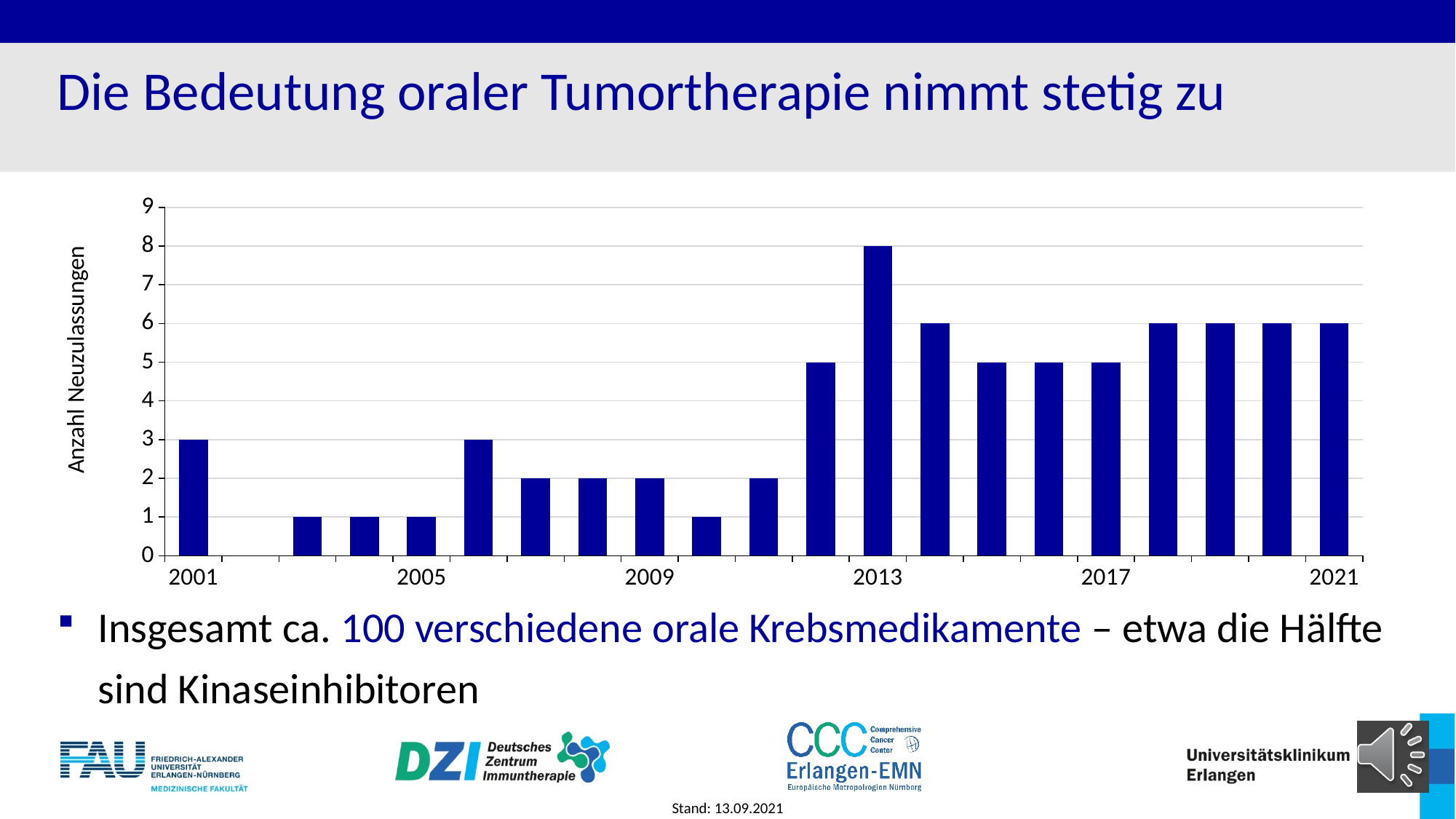
What kind of chart is shown on the slide? bar chart What is the value for 2021 in the chart? 6 What is the value for 2017 in the chart? 5 What is the value for 2009 in the chart? 2 What is the value for 2005 in the chart? 1 Do the values generally rise or fall from 2001 to 2021? rise Which year has the highest number of Neuzulassungen? 2013 What is the label of the vertical axis? Anzahl Neuzulassungen What is the value for 2013 in the chart? 8 What is the value for 2001 in the chart? 3 What is the difference between the values for 2013 and 2001? 5 Which year has the larger value, 2021 or 2017? 2021